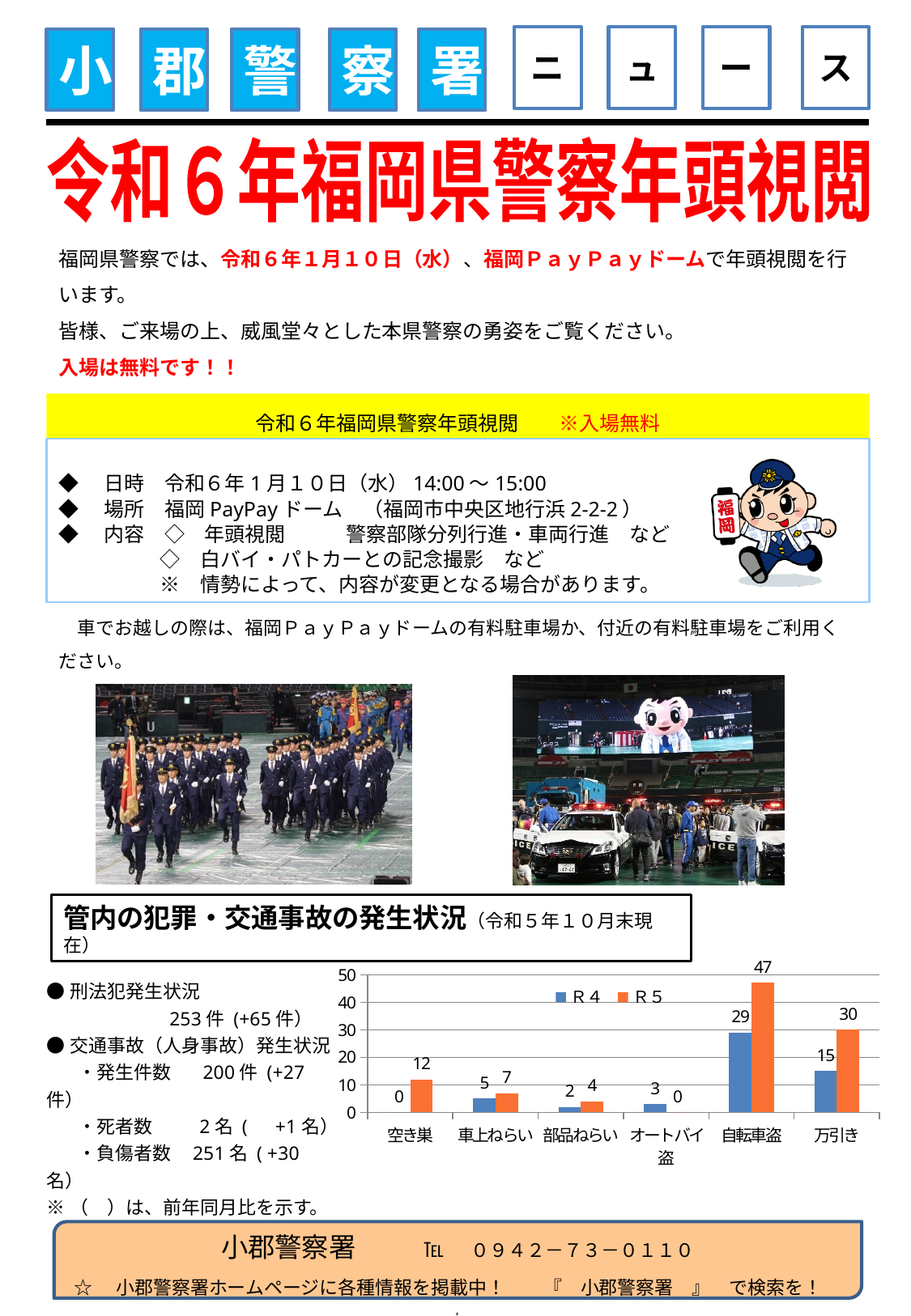
Which colour represents the R5 series in the chart? Orange What is the R4 value for 万引き in the chart? 15 What is the R5 value for 空き巣 in the chart? 12 What kind of chart is shown on the slide? Bar chart Which category has the highest R5 value in the chart? 自転車盗 What is the R5 value for 自転車盗 in the chart? 47 Which category has the lowest R4 value in the chart? 空き巣 Which is larger for オートバイ盗, the R4 value or the R5 value? R4 How many series does the chart legend list? 2 What is the difference between the R5 and R4 values for 自転車盗? 18 How many categories are shown on the x axis of the chart? 6 What is the difference between the R5 and R4 values for 万引き? 15